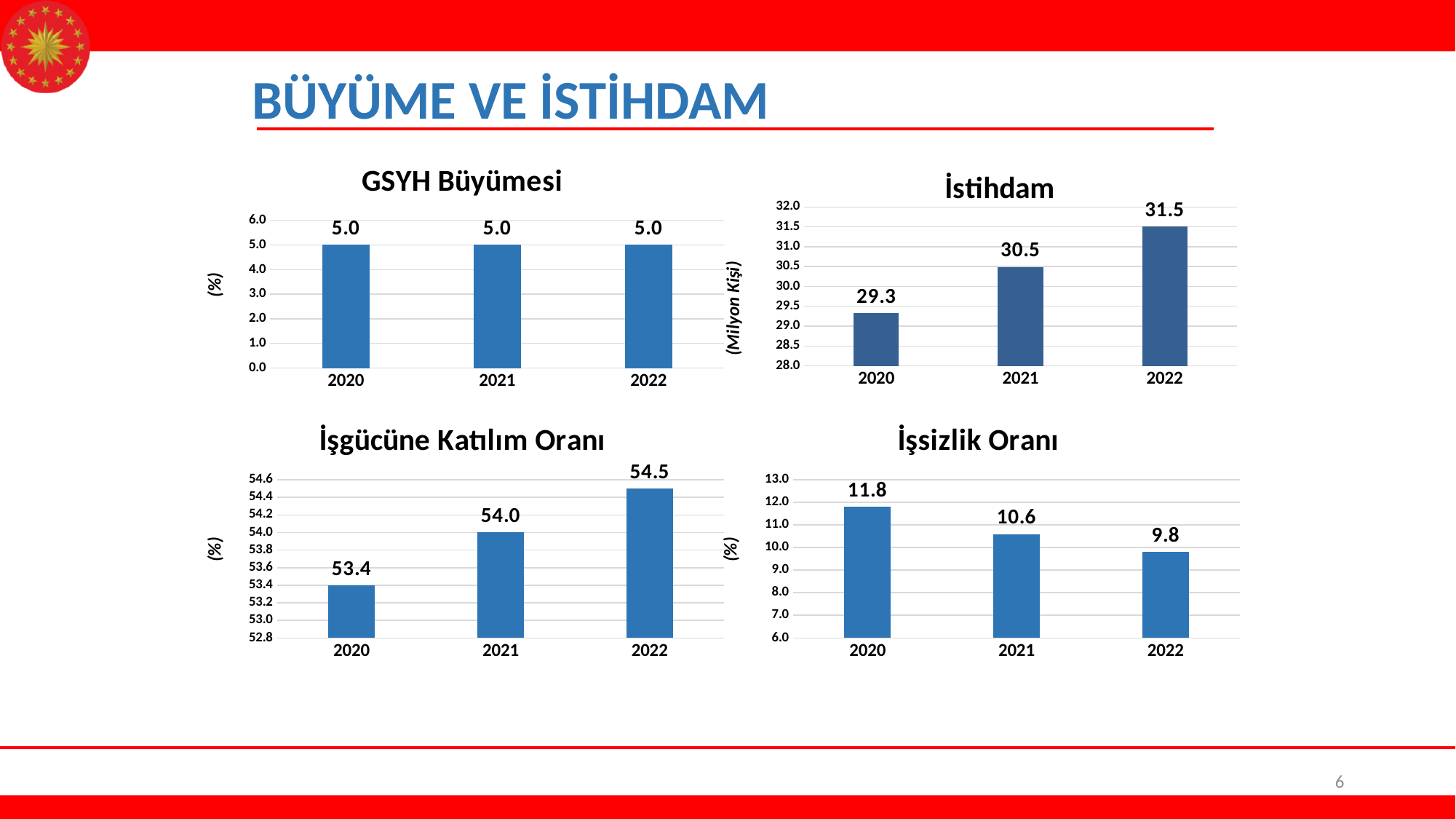
How many bars does the 'GSYH Büyümesi' chart have? 3 In the 'İşsizlik Oranı' chart, what is the difference between the 2020 and 2022 values? 2.0 In the 'İstihdam' chart, what is the difference between the 2022 and 2020 values? 2.2 In the 'İşsizlik Oranı' chart, do the values rise or fall from 2020 to 2022? Fall In the 'GSYH Büyümesi' chart, what is the value for 2021? 5.0 In the 'İstihdam' chart, which year has the highest value? 2022 In the 'İstihdam' chart, what is the value for 2022? 31.5 In the 'İşgücüne Katılım Oranı' chart, is the value for 2022 larger than the value for 2020? Yes In the 'İşsizlik Oranı' chart, what is the value for 2020? 11.8 In the 'İşsizlik Oranı' chart, which year has the lowest value? 2022 In the 'İşgücüne Katılım Oranı' chart, what is the value for 2021? 54.0 What type of chart is the 'İstihdam' chart? Bar chart